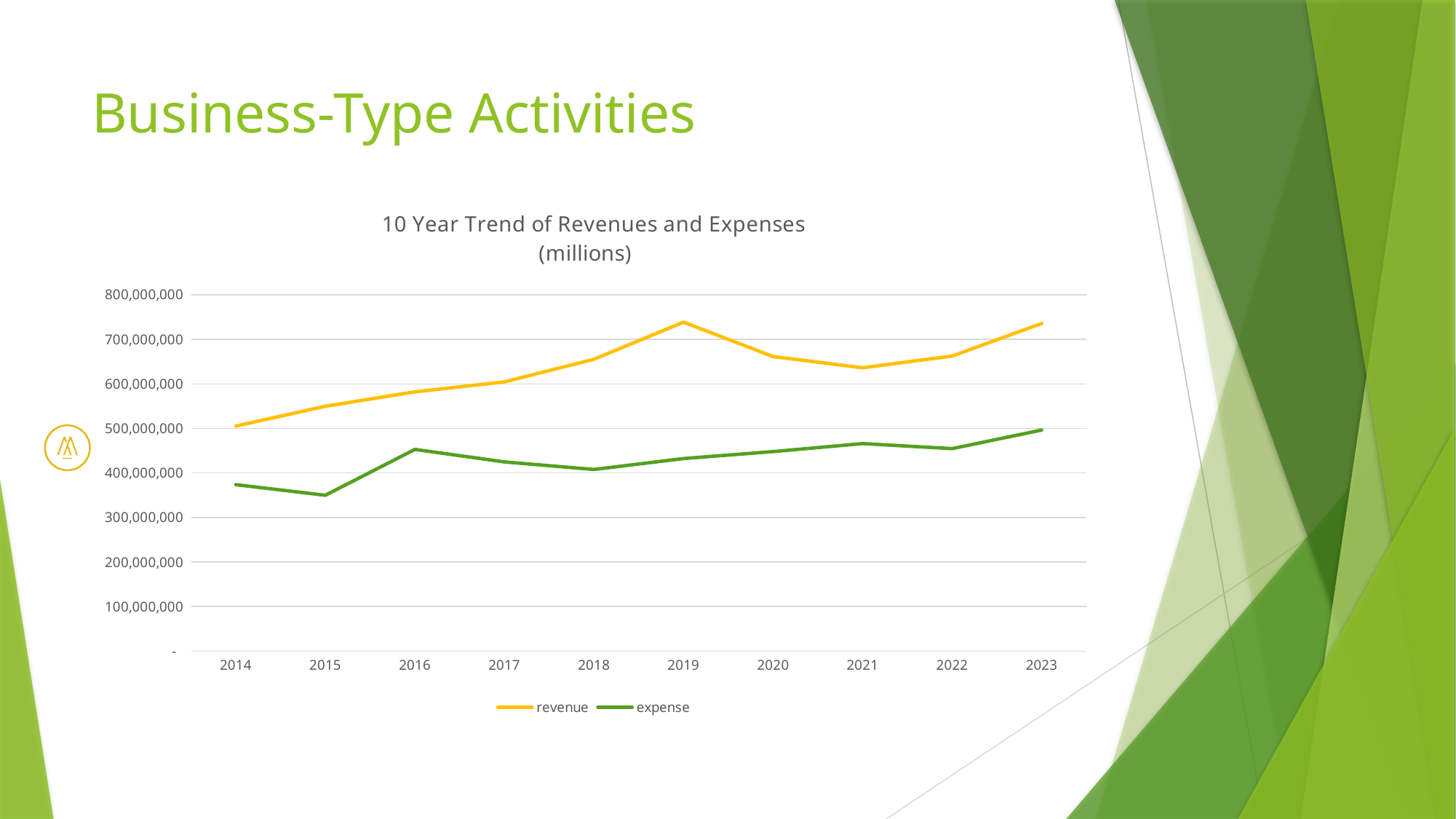
In which year is expense lowest? 2015 Which is larger, revenue in 2019 or revenue in 2021? revenue in 2019 In which year is expense highest? 2023 How many series does the legend list? 2 Is the revenue value for 2019 greater or less than 700,000,000? greater Does revenue rise or fall from 2014 to 2019? rise Which is larger, expense in 2016 or expense in 2018? expense in 2016 How many years are plotted along the x axis? 10 In which year is revenue lowest? 2014 Is the expense value for 2015 greater or less than 400,000,000? less Is the revenue value for 2021 greater or less than 600,000,000? greater What kind of chart is shown on the slide? line chart